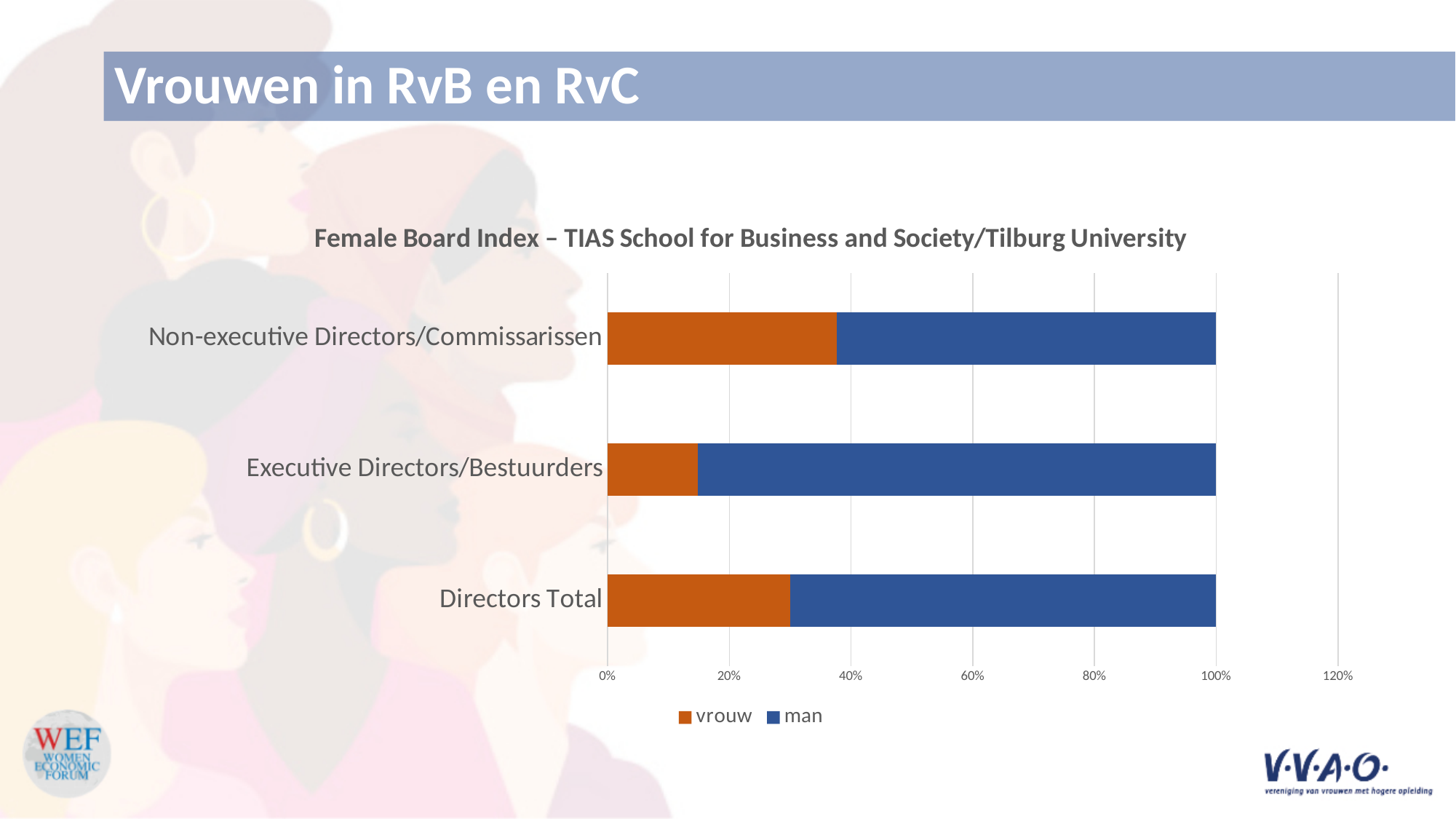
What kind of chart is shown on the slide? bar chart Is the 'vrouw' share for Executive Directors/Bestuurders greater or less than 20%? less How many series does the legend list? 2 Is the 'vrouw' share for Non-executive Directors/Commissarissen greater or less than 20%? greater Which category has the largest share for 'vrouw'? Non-executive Directors/Commissarissen Is the 'vrouw' share for Directors Total greater or less than 40%? less What is the title of the chart? Female Board Index – TIAS School for Business and Society/Tilburg University Which category has the smallest share for 'vrouw'? Executive Directors/Bestuurders Which colour represents the 'man' series in the legend? blue How many categories are shown on the chart? 3 Which is larger: the 'vrouw' share for Non-executive Directors/Commissarissen or for Directors Total? Non-executive Directors/Commissarissen